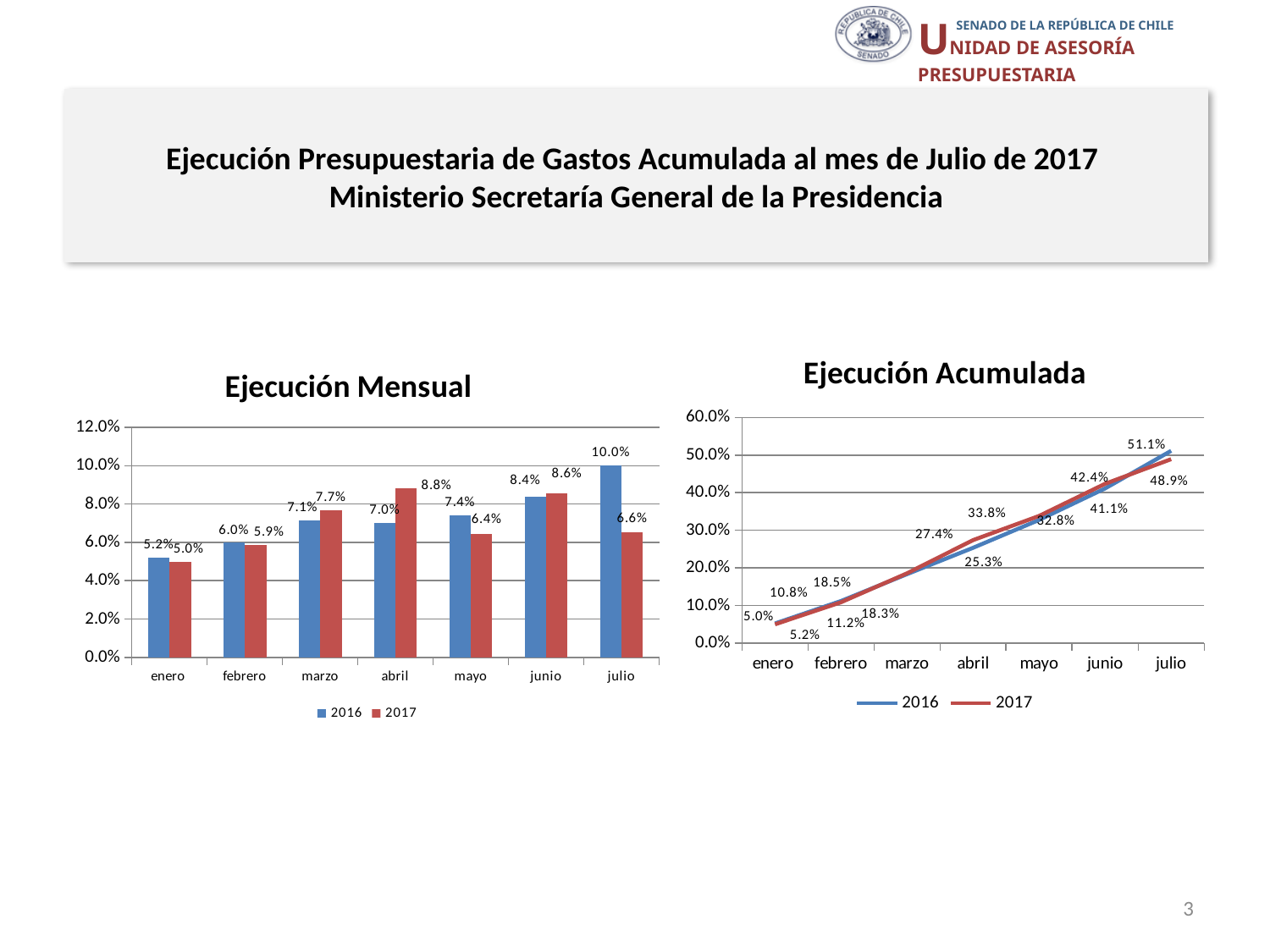
In the 'Ejecución Acumulada' chart, what is the value for 2016 in julio? 51.1% What kind of chart is 'Ejecución Mensual'? bar chart In the 'Ejecución Mensual' chart, how many months are shown on the x axis? 7 In the 'Ejecución Acumulada' chart, do the values rise or fall from enero to julio? rise In the 'Ejecución Mensual' chart, what is the value for 2016 in julio? 10.0% In the 'Ejecución Mensual' chart, which series has the larger value in mayo, 2016 or 2017? 2016 In the 'Ejecución Mensual' chart, which month has the highest value for the 2016 series? julio How many series does the legend of the 'Ejecución Acumulada' chart list? 2 In the 'Ejecución Mensual' chart, which month has the lowest value for the 2017 series? enero In the 'Ejecución Mensual' chart, what is the value for 2017 in abril? 8.8% What kind of chart is 'Ejecución Acumulada'? line chart In the 'Ejecución Mensual' chart, what is the difference between the 2016 and 2017 values in julio? 3.4%